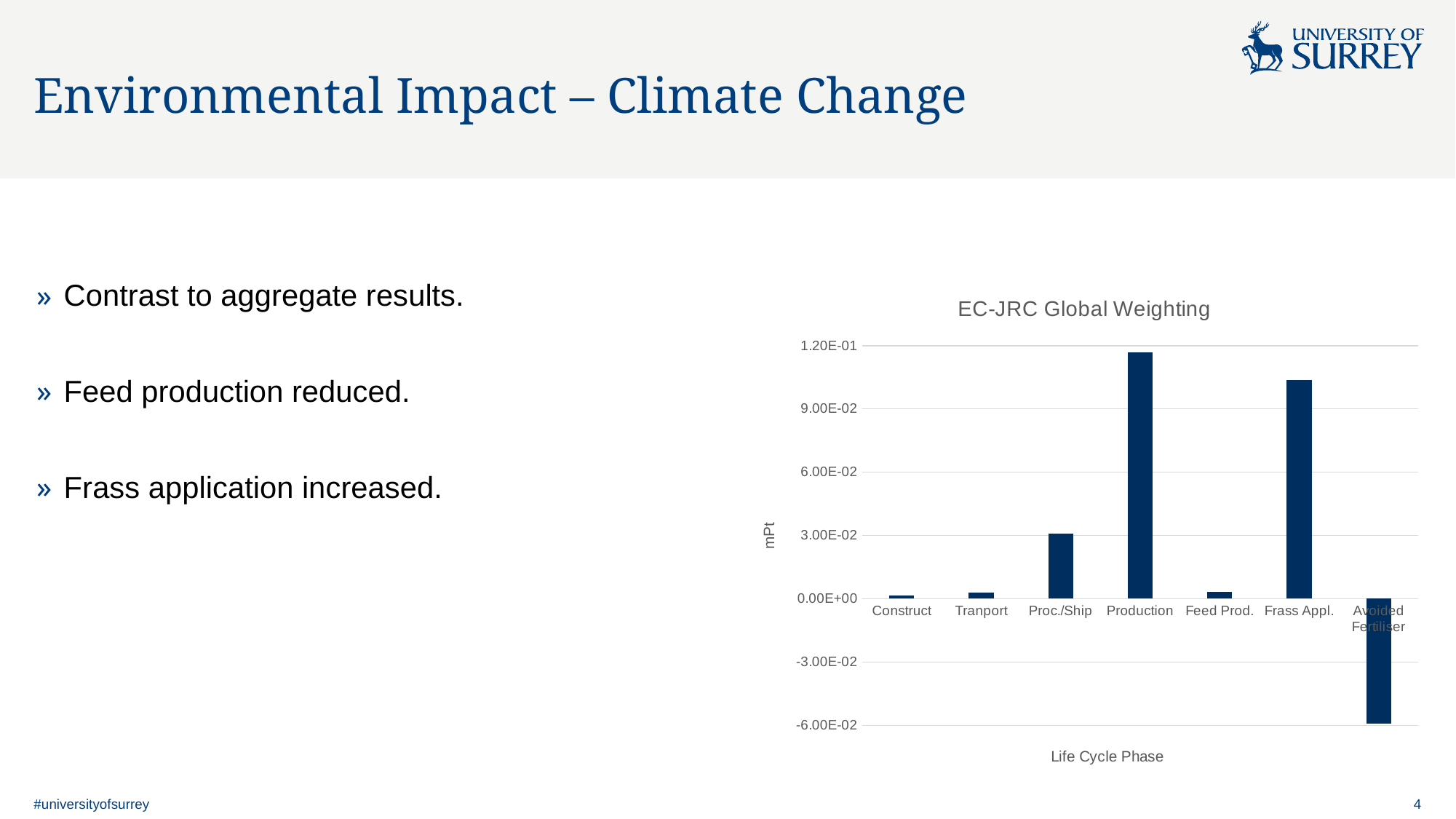
Is the value for Avoided Fertiliser greater or less than -3.00E-02? less Is the value for Production greater or less than 9.00E-02? greater Is the value for Frass Appl. greater or less than 9.00E-02? greater How many life cycle phases are plotted on the x axis of the chart? 7 What kind of chart is shown on the slide? Bar chart What is the title of the chart? EC-JRC Global Weighting What is the label of the y axis of the chart? mPt Which has a larger value, Production or Frass Appl.? Production Which life cycle phase has the lowest value in the chart? Avoided Fertiliser Which life cycle phase has the highest value in the chart? Production Which has a larger value, Proc./Ship or Tranport? Proc./Ship